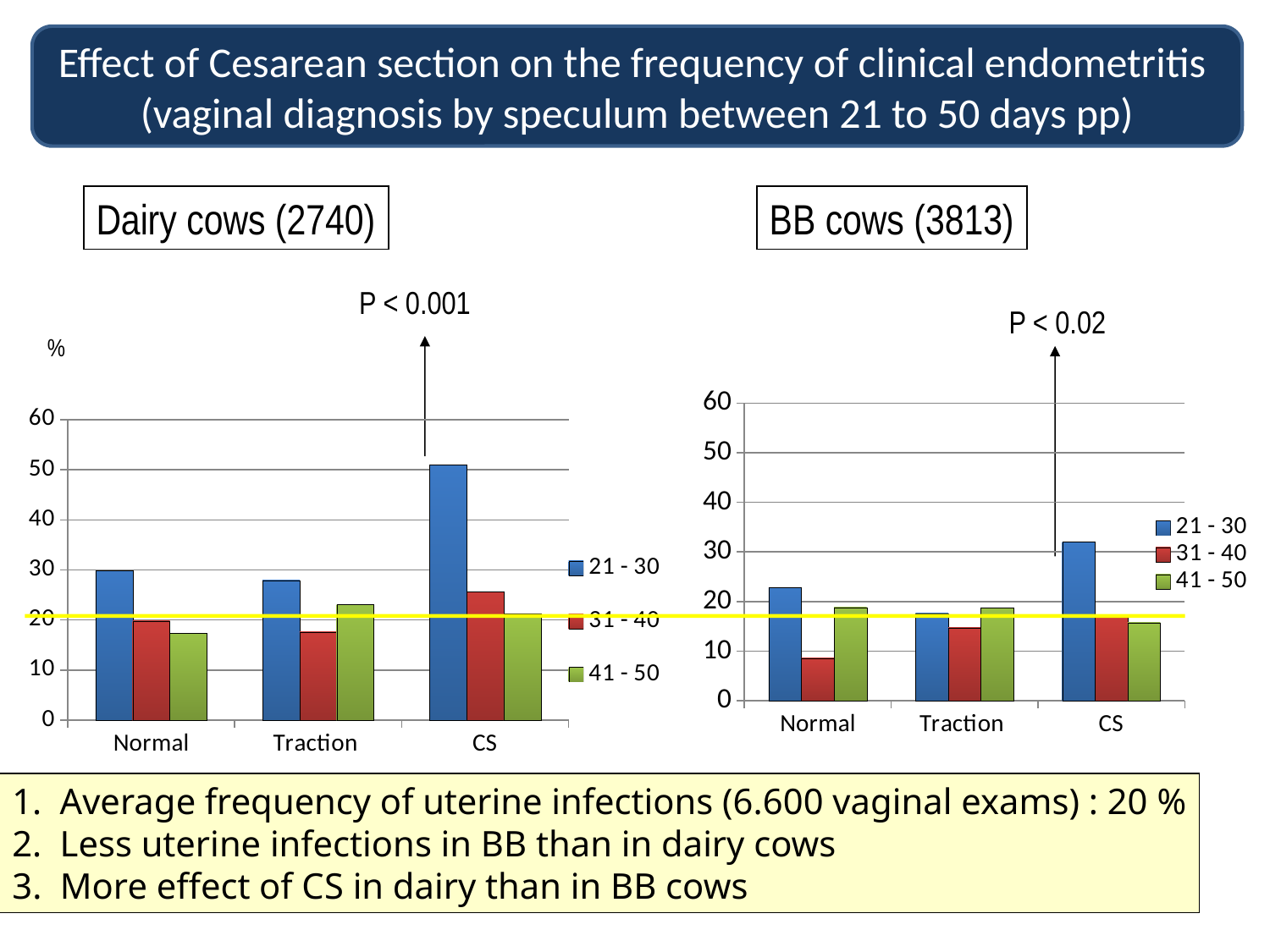
How many categories are shown on the x axis of the Dairy cows (2740) chart? 3 What P value is annotated above the CS bars in the BB cows (3813) chart? P < 0.02 In the Dairy cows (2740) chart, which category has the highest bar? CS In the BB cows (3813) chart, is the value for Normal in the 31 - 40 series greater or less than 10? less In the BB cows (3813) chart, which category and series has the lowest bar? Normal, 31 - 40 How many series does the legend of the BB cows (3813) chart list? 3 What kind of chart is the Dairy cows (2740) chart? bar chart In the BB cows (3813) chart, is the value for CS in the 21 - 30 series greater or less than 30? greater In the Dairy cows (2740) chart, is the value for Traction in the 31 - 40 series greater or less than 20? less In the Dairy cows (2740) chart, which is larger in the 21 - 30 series: Normal or CS? CS In the BB cows (3813) chart, for the Normal category, which series is larger: 31 - 40 or 41 - 50? 41 - 50